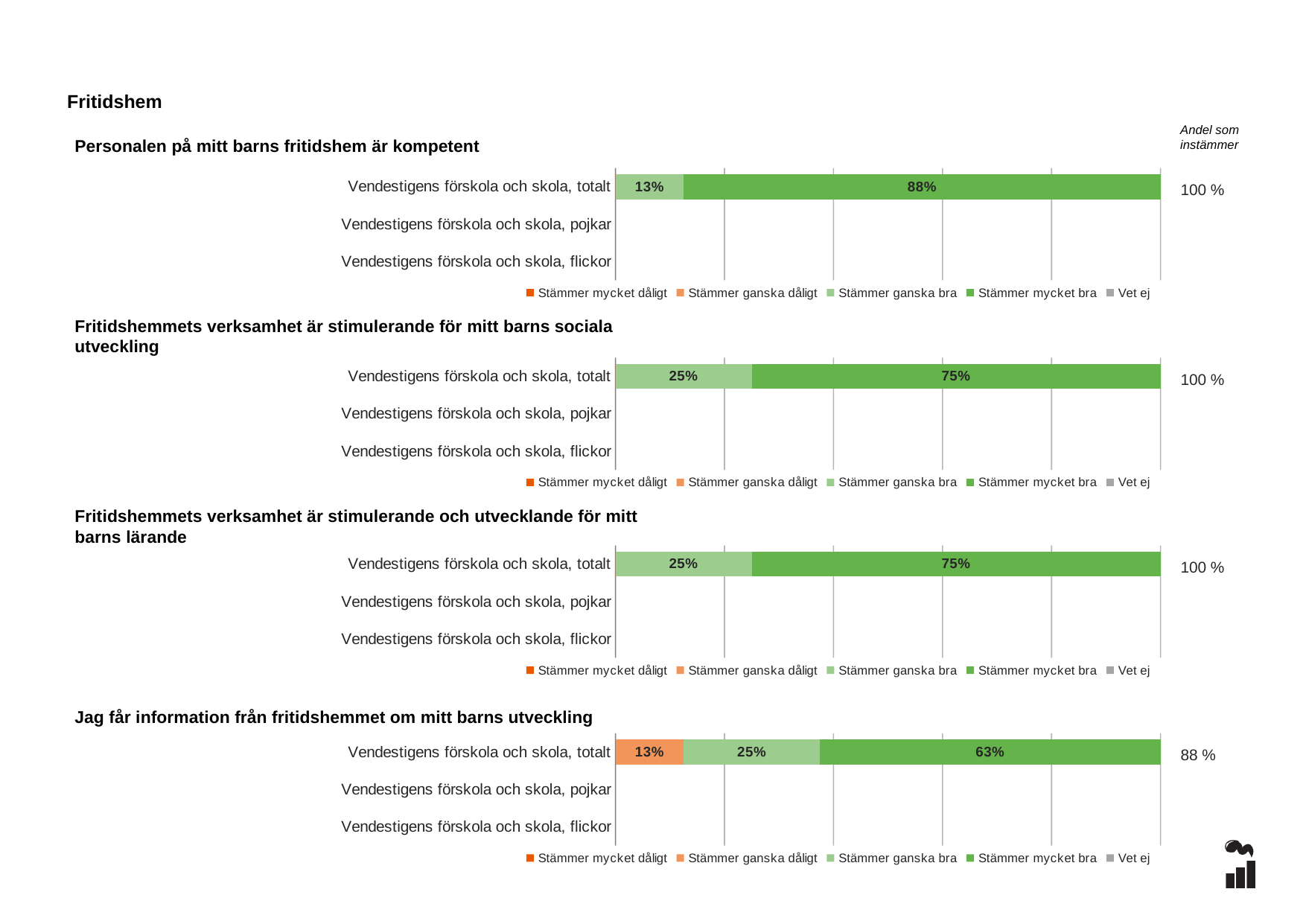
How many series does the legend list in the chart 'Personalen på mitt barns fritidshem är kompetent'? 5 What kind of chart is 'Fritidshemmets verksamhet är stimulerande och utvecklande för mitt barns lärande'? Stacked bar chart In the chart 'Personalen på mitt barns fritidshem är kompetent', which response is larger for 'Vendestigens förskola och skola, totalt': 'Stämmer ganska bra' or 'Stämmer mycket bra'? Stämmer mycket bra In the chart 'Personalen på mitt barns fritidshem är kompetent', what percentage of 'Vendestigens förskola och skola, totalt' answered 'Stämmer mycket bra'? 88% In the chart 'Jag får information från fritidshemmet om mitt barns utveckling', what percentage of 'Vendestigens förskola och skola, totalt' answered 'Stämmer mycket bra'? 63% In the chart 'Jag får information från fritidshemmet om mitt barns utveckling', what percentage of 'Vendestigens förskola och skola, totalt' answered 'Stämmer ganska dåligt'? 13% In the chart 'Jag får information från fritidshemmet om mitt barns utveckling', what is the difference between the 'Stämmer mycket bra' and 'Stämmer ganska bra' shares for 'Vendestigens förskola och skola, totalt'? 38% In the chart 'Personalen på mitt barns fritidshem är kompetent', what percentage of 'Vendestigens förskola och skola, totalt' answered 'Stämmer ganska bra'? 13% In the chart 'Jag får information från fritidshemmet om mitt barns utveckling', what is the 'Andel som instämmer' value shown for 'Vendestigens förskola och skola, totalt'? 88 % In the chart 'Fritidshemmets verksamhet är stimulerande för mitt barns sociala utveckling', what percentage of 'Vendestigens förskola och skola, totalt' answered 'Stämmer mycket bra'? 75% How many categories are shown on the vertical axis of the chart 'Jag får information från fritidshemmet om mitt barns utveckling'? 3